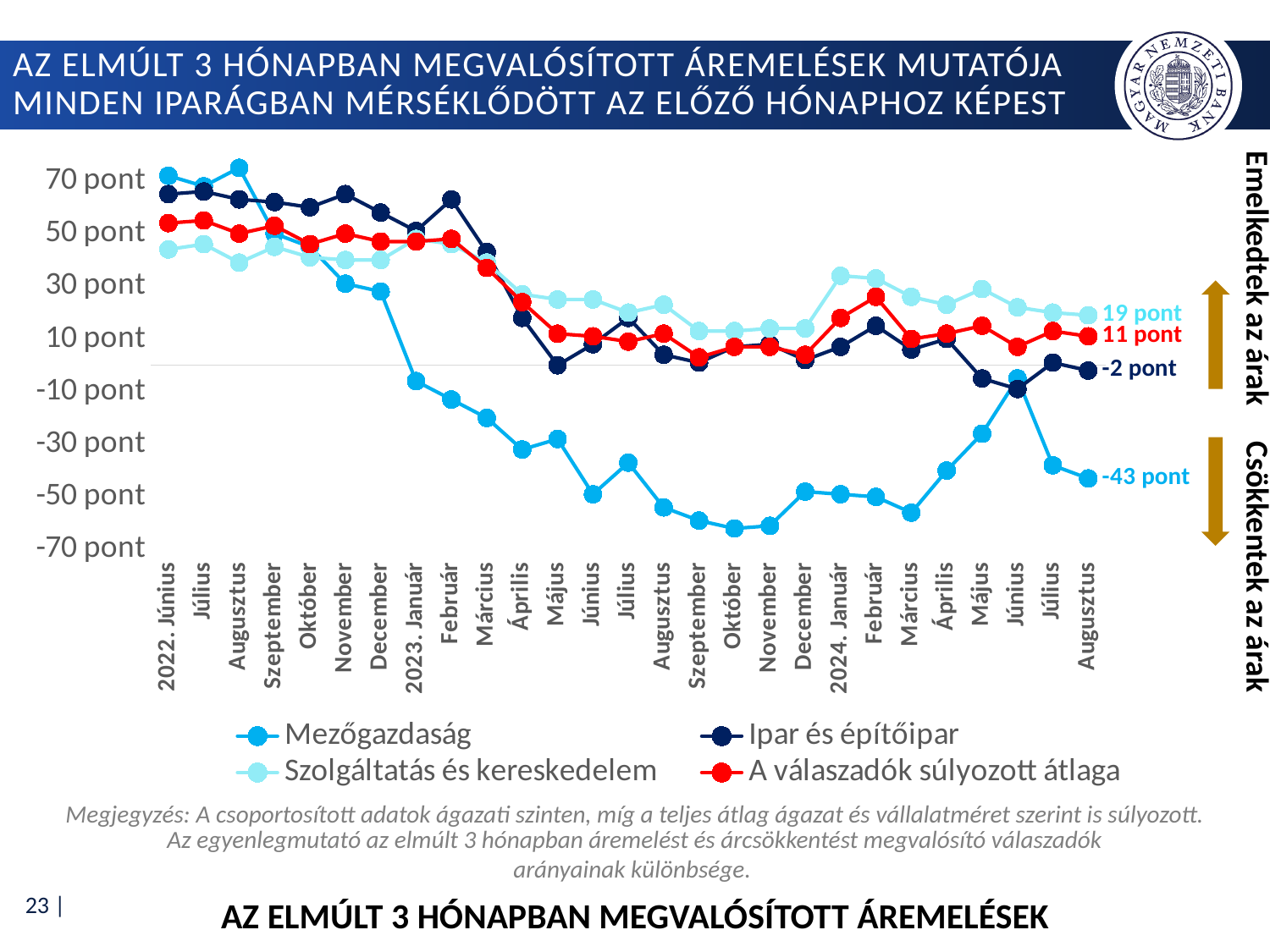
Does the Mezőgazdaság series rise or fall from 2022. Június to 2024 Augusztus? fall What is the value for Szolgáltatás és kereskedelem in 2024 Augusztus? 19 pont Which series has the highest value in 2024 Augusztus? Szolgáltatás és kereskedelem What is the value for A válaszadók súlyozott átlaga in 2024 Augusztus? 11 pont What is the difference between Szolgáltatás és kereskedelem and Mezőgazdaság in 2024 Augusztus? 62 pont What is the value for Ipar és építőipar in 2024 Augusztus? -2 pont How many series does the legend list? 4 Which series has the lowest value in 2024 Augusztus? Mezőgazdaság What is the value for Mezőgazdaság in 2024 Augusztus? -43 pont What kind of chart is shown on the slide? line chart Is the value for Mezőgazdaság in 2023 Október greater or less than -50 pont? less How many months are plotted along the x axis? 27